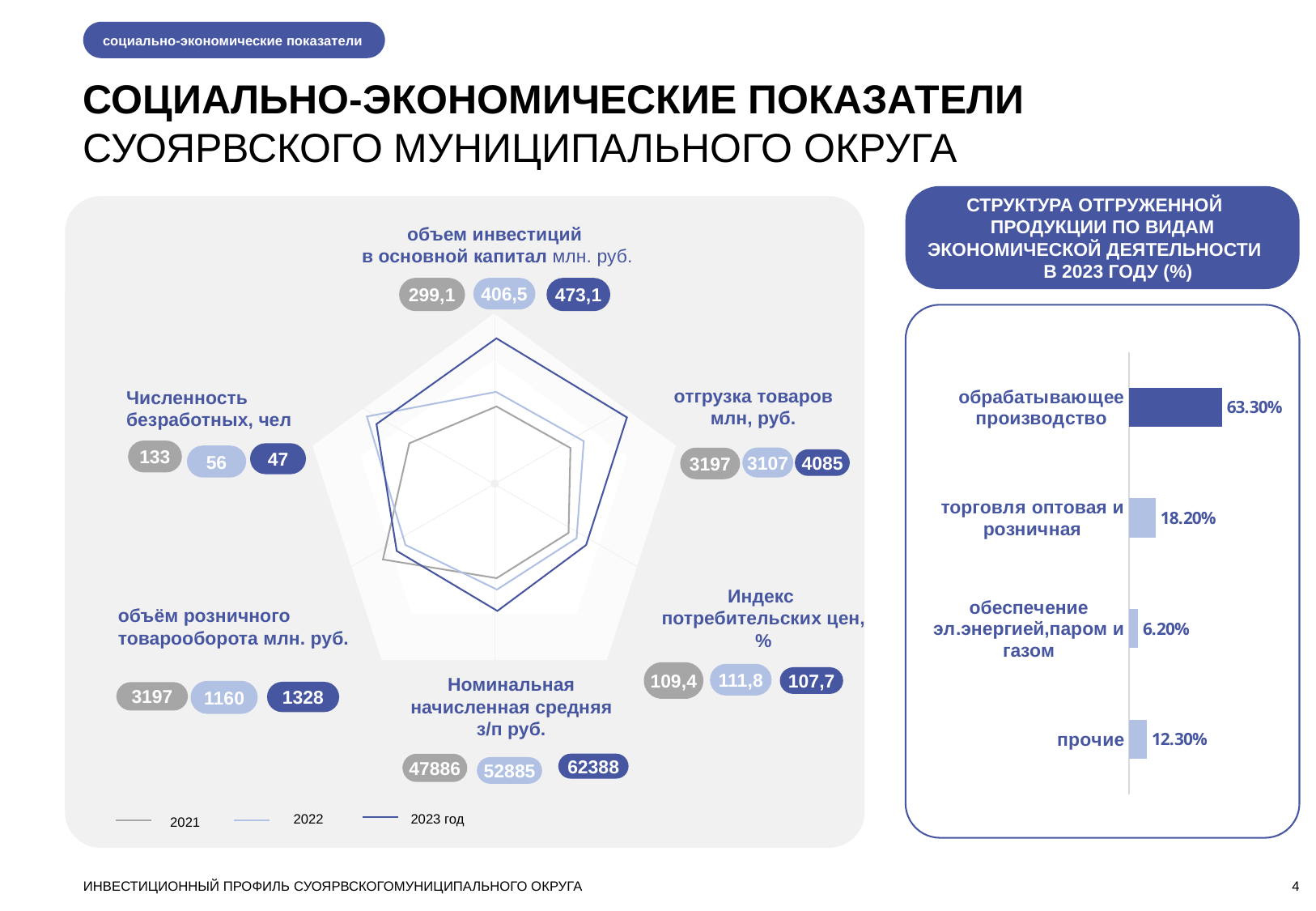
What type of chart is shown on the left side of the slide? radar chart In the bar chart on the right, which category has the lowest value? обеспечение эл.энергией, паром и газом In the radar chart on the left, what is the value of объем инвестиций в основной капитал for 2023? 473,1 In the bar chart on the right, how many categories are shown? 4 In the bar chart on the right, what is the difference between обрабатывающее производство and торговля оптовая и розничная? 45.10% In the bar chart on the right, which category has the highest value? обрабатывающее производство In the radar chart on the left, how many series does the legend list? 3 In the bar chart on the right, what is the share of обрабатывающее производство? 63.30% What type of chart is shown on the right side of the slide? bar chart In the bar chart on the right, what is the value for торговля оптовая и розничная? 18.20% In the radar chart on the left, what is the difference between the Номинальная начисленная средняя з/п for 2023 and 2021? 14502 In the radar chart on the left, what is the value of Численность безработных for 2021? 133